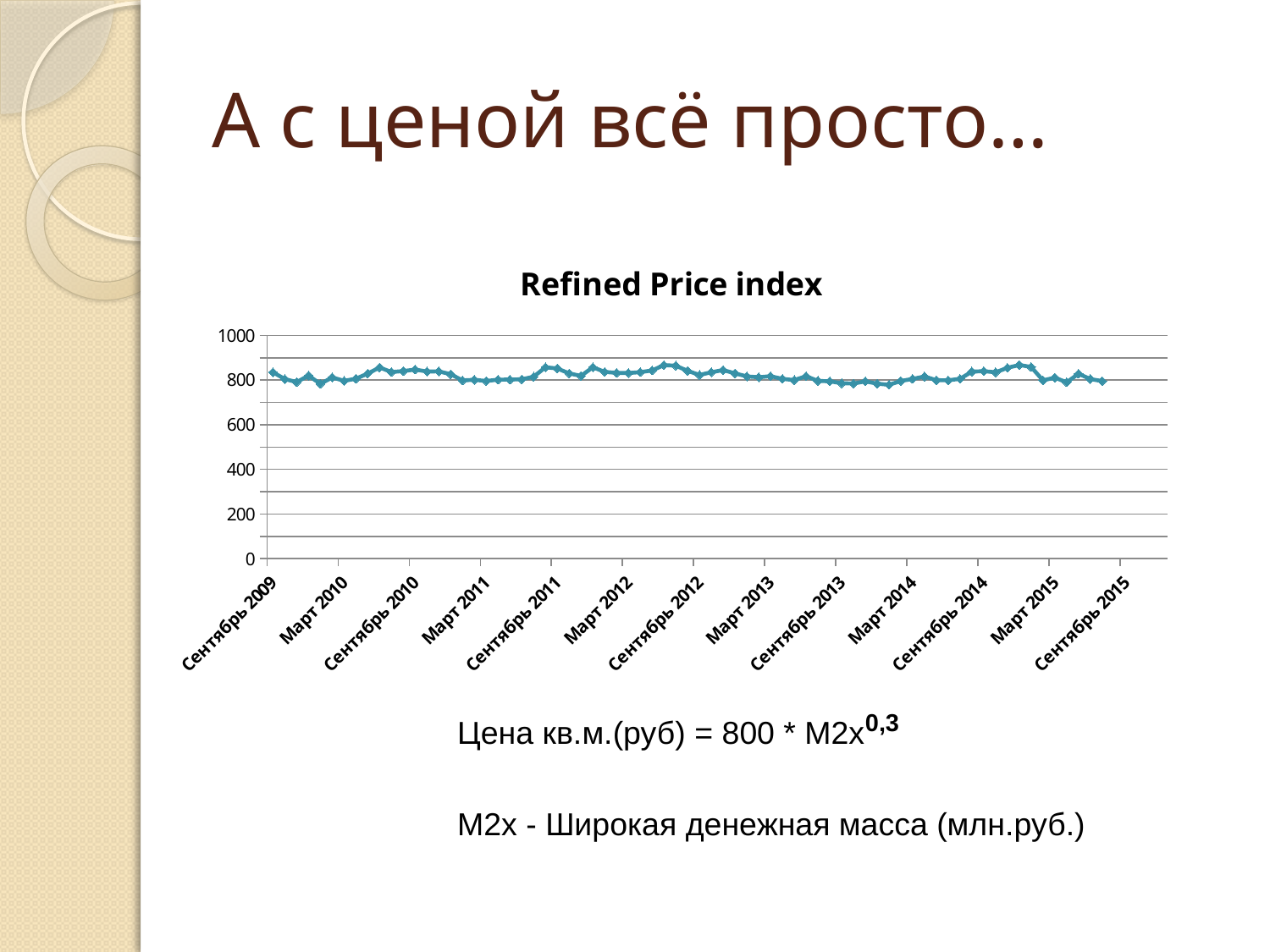
Does the line ever rise above 1000 on the chart? no Do the values rise strongly, fall strongly, or stay roughly flat from Сентябрь 2009 to Сентябрь 2015? stay roughly flat What kind of chart is shown on the slide? line chart How many date labels are shown on the x axis? 13 Does the line ever fall below 600 on the chart? no What is the highest value shown on the y axis? 1000 Is the value for Март 2010 greater or less than 1000? less What is the title of the chart? Refined Price index